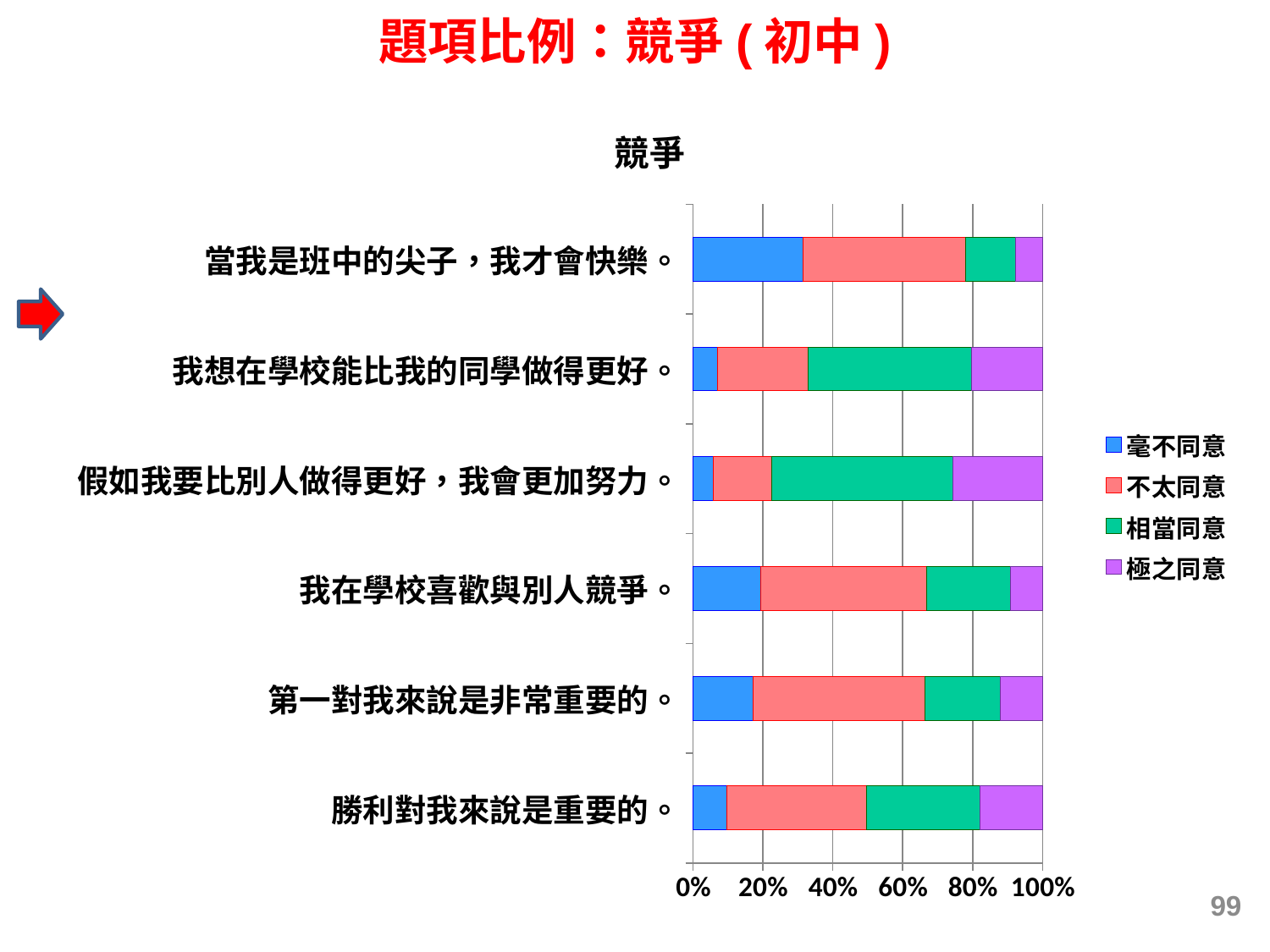
What is the title shown above the chart? 競爭 Which has the larger 毫不同意 share: 「當我是班中的尖子，我才會快樂。」 or 「勝利對我來說是重要的。」? 當我是班中的尖子，我才會快樂。 How many series does the legend of the 競爭 chart list? 4 Which statement has the largest 毫不同意 share? 當我是班中的尖子，我才會快樂。 Which has the larger 相當同意 share: 「假如我要比別人做得更好，我會更加努力。」 or 「當我是班中的尖子，我才會快樂。」? 假如我要比別人做得更好，我會更加努力。 How many statements (categories) are plotted in the 競爭 chart? 6 Is the 毫不同意 share for 「當我是班中的尖子，我才會快樂。」 greater or less than 20%? greater Is the 毫不同意 share for 「假如我要比別人做得更好，我會更加努力。」 greater or less than 20%? less Is the 相當同意 share for 「假如我要比別人做得更好，我會更加努力。」 greater or less than 40%? greater What are the four legend entries in the 競爭 chart? 毫不同意, 不太同意, 相當同意, 極之同意 What kind of chart is shown on the slide? stacked bar chart